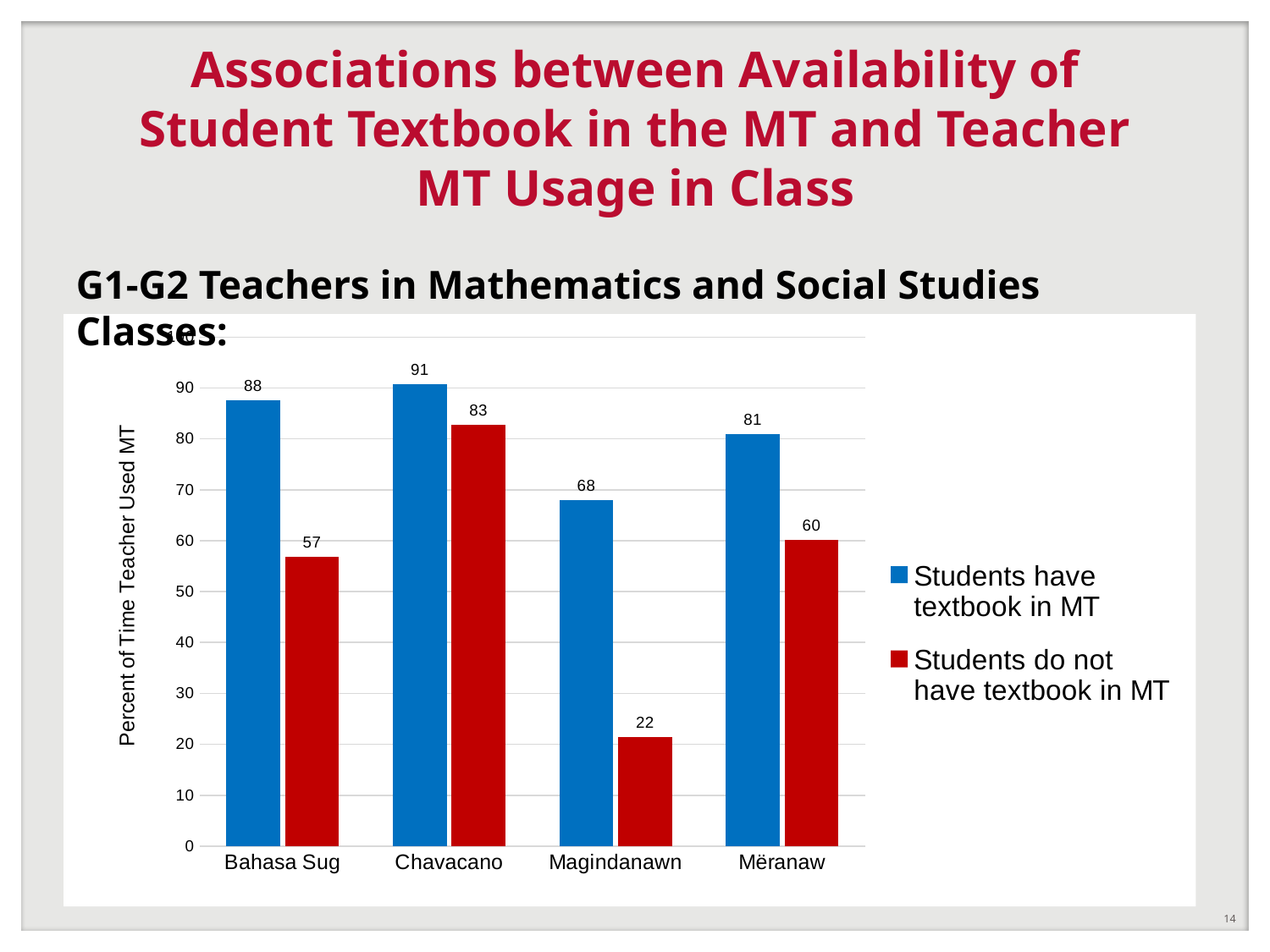
Which category has the lowest value in the 'Students do not have textbook in MT' series? Magindanawn For Bahasa Sug, which series has the larger value? Students have textbook in MT What kind of chart is shown on the slide? Bar chart What is the difference between the two series for Magindanawn? 46 What is the value for Magindanawn in the 'Students do not have textbook in MT' series? 22 How many series does the legend list? 2 What is the value for Bahasa Sug in the 'Students have textbook in MT' series? 88 What is the value for Mëranaw in the 'Students do not have textbook in MT' series? 60 What is the difference between the two series for Chavacano? 8 Which category has the highest value in the 'Students have textbook in MT' series? Chavacano How many language categories are shown on the x axis? 4 What is the label of the vertical axis? Percent of Time Teacher Used MT